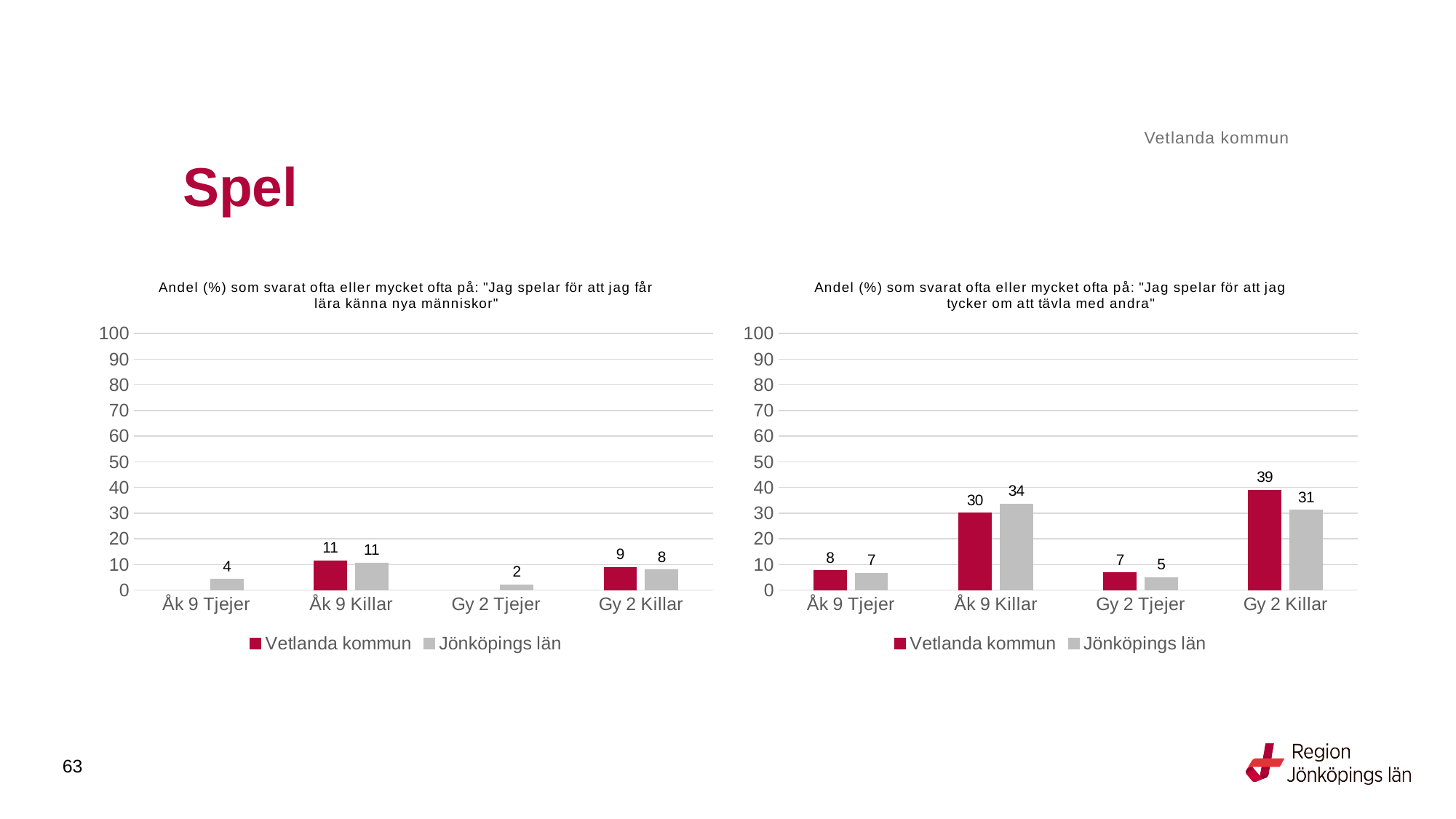
In the right chart, what is the difference between Vetlanda kommun and Jönköpings län for Gy 2 Killar? 8 In the right chart, which category has the lowest value for Jönköpings län? Gy 2 Tjejer In the left chart, what is the value for Vetlanda kommun for Gy 2 Killar? 9 In the left chart, what is the value for Jönköpings län for Åk 9 Tjejer? 4 In the right chart, which is larger for Åk 9 Killar: Vetlanda kommun or Jönköpings län? Jönköpings län In the right chart, which category has the highest value for Vetlanda kommun? Gy 2 Killar How many categories are shown on the x axis of the left chart? 4 In the right chart, what is the value for Vetlanda kommun for Gy 2 Killar? 39 How many series does the legend of the right chart list? 2 What type of chart is the left chart? Bar chart In the left chart, what is the value for Jönköpings län for Gy 2 Tjejer? 2 In the right chart, what is the value for Jönköpings län for Åk 9 Killar? 34